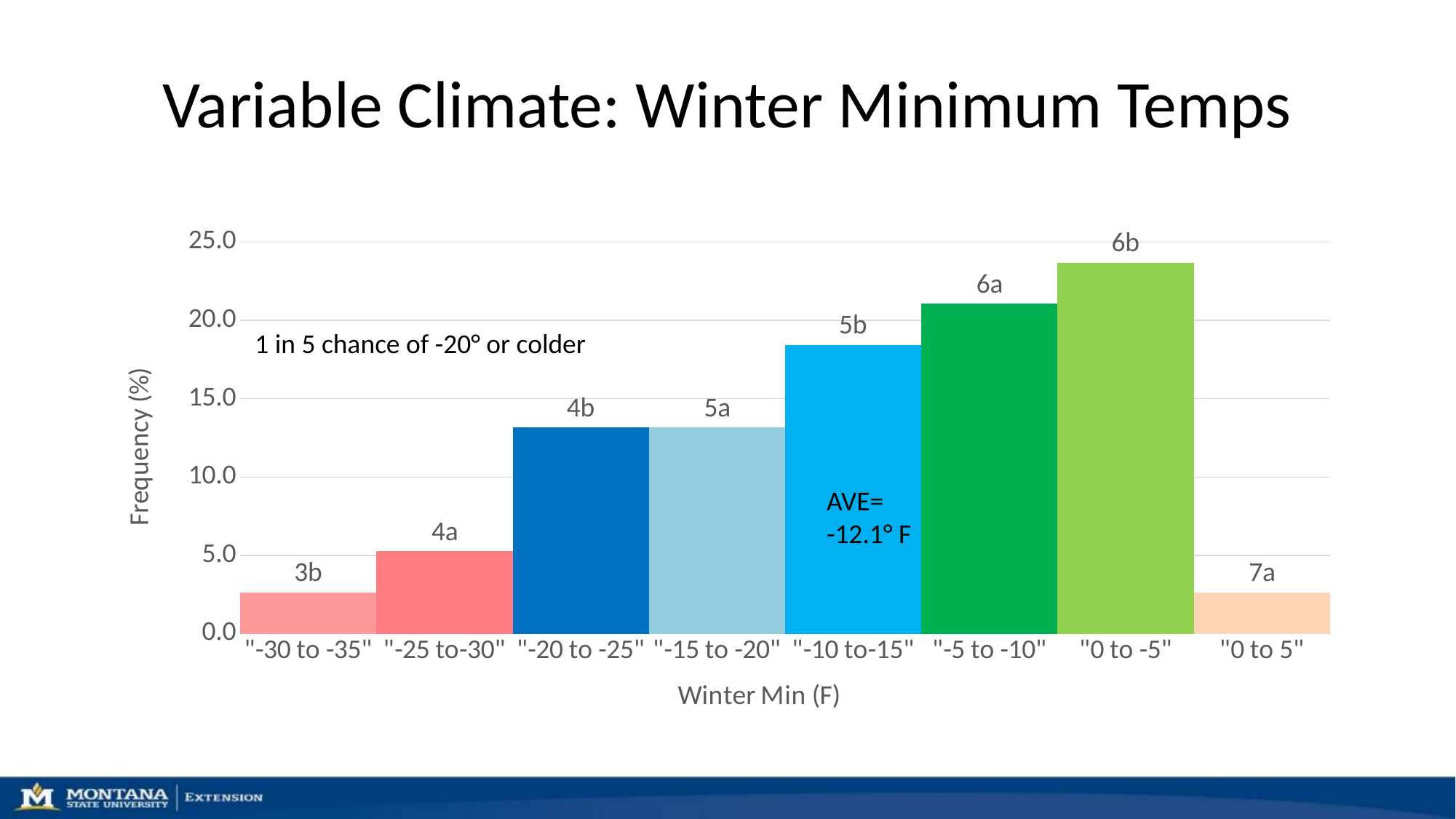
What kind of chart is shown on the slide? bar chart Is the frequency for "-25 to-30" greater or less than 10? less How many temperature categories are plotted along the x axis? 8 What zone label is printed above the tallest bar? 6b Is the frequency for "-30 to -35" greater or less than 5? less Which has the higher frequency, "-5 to -10" or "-10 to-15"? "-5 to -10" What average winter minimum temperature is annotated on the chart? -12.1° F Is the frequency for "0 to 5" greater or less than 5? less Which winter minimum temperature category has the highest frequency? "0 to -5"